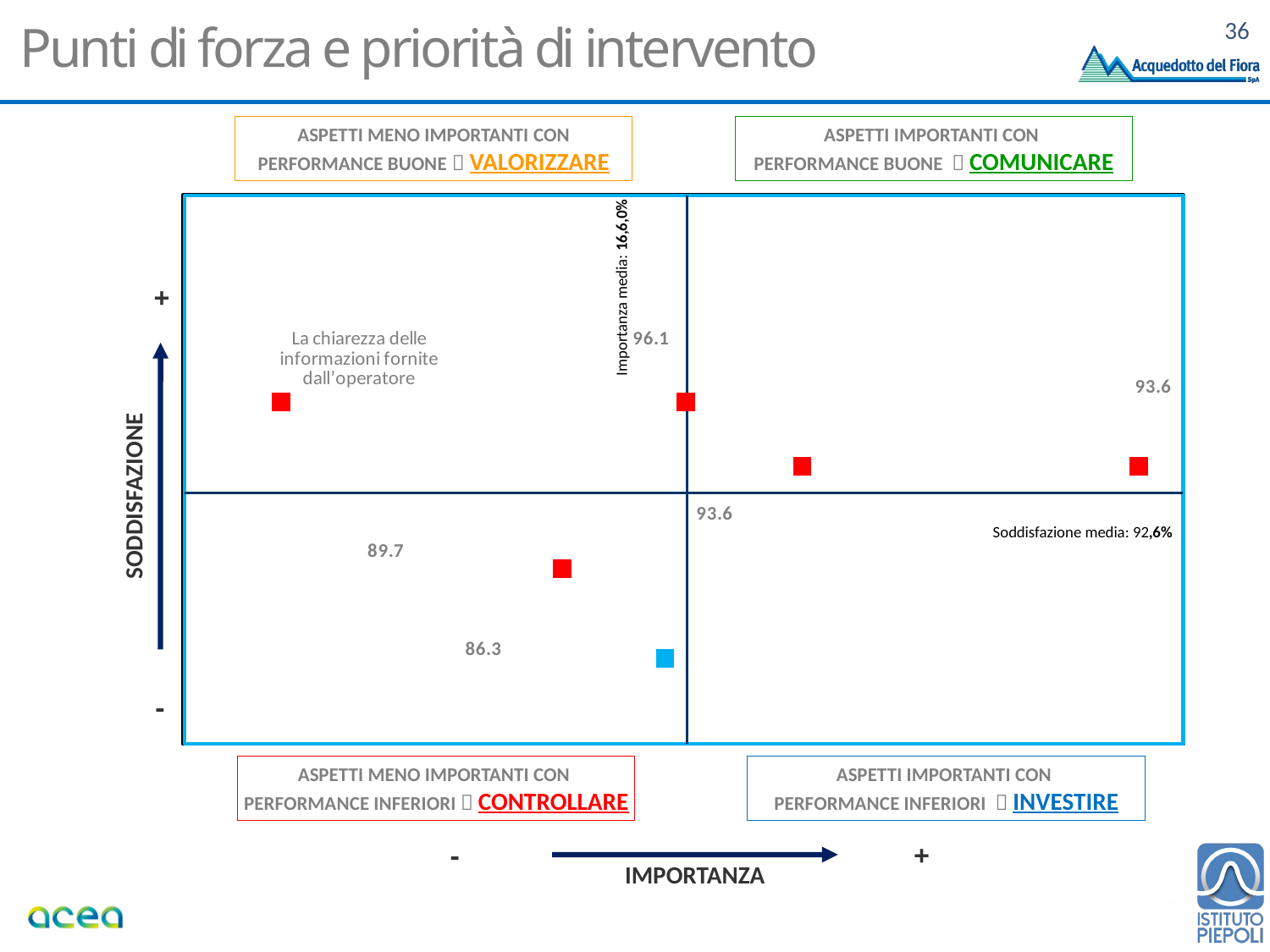
Which labelled item is plotted in the upper-left quadrant of the chart? La chiarezza delle informazioni fornite dall'operatore What is the 'Soddisfazione media' value shown on the chart? 92,6% How many data points lie in the lower-right (INVESTIRE) quadrant of the chart? 0 What is the difference between the highest data label (96.1) and the lowest data label (86.3) on the chart? 9.8 How many data points are plotted on the chart? 6 What is the highest data label value shown on the chart? 96.1 What kind of chart is shown on the slide? scatter chart What is the label of the horizontal axis of the chart? IMPORTANZA Which is larger, the data label 89.7 or the data label 86.3? 89.7 What is the lowest data label value shown on the chart? 86.3